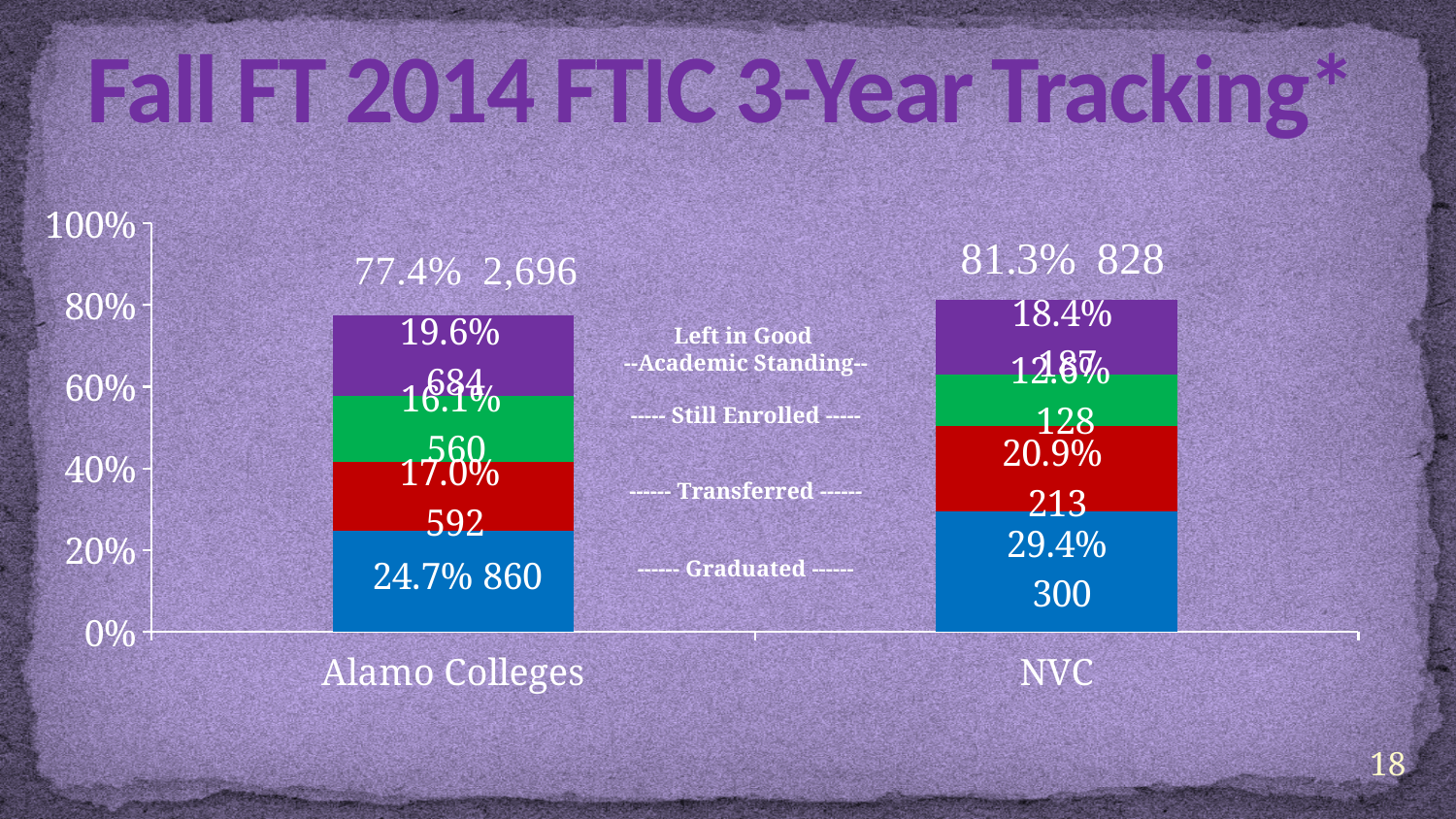
What is the Left in Good Academic Standing percentage for Alamo Colleges? 19.6% What kind of chart is shown on the slide? stacked bar chart What is the Transferred percentage for NVC? 20.9% What is the Transferred count for Alamo Colleges? 592 How many categories are shown on the x axis? 2 What is the Graduated count for NVC? 300 What is the total percentage shown above the NVC bar? 81.3% What is the Graduated percentage for Alamo Colleges? 24.7% What is the difference in Graduated percentage between NVC and Alamo Colleges? 4.7% Which category has the higher Graduated percentage, Alamo Colleges or NVC? NVC Is the total height of the Alamo Colleges bar greater or less than 80%? less What is the total count shown above the Alamo Colleges bar? 2,696